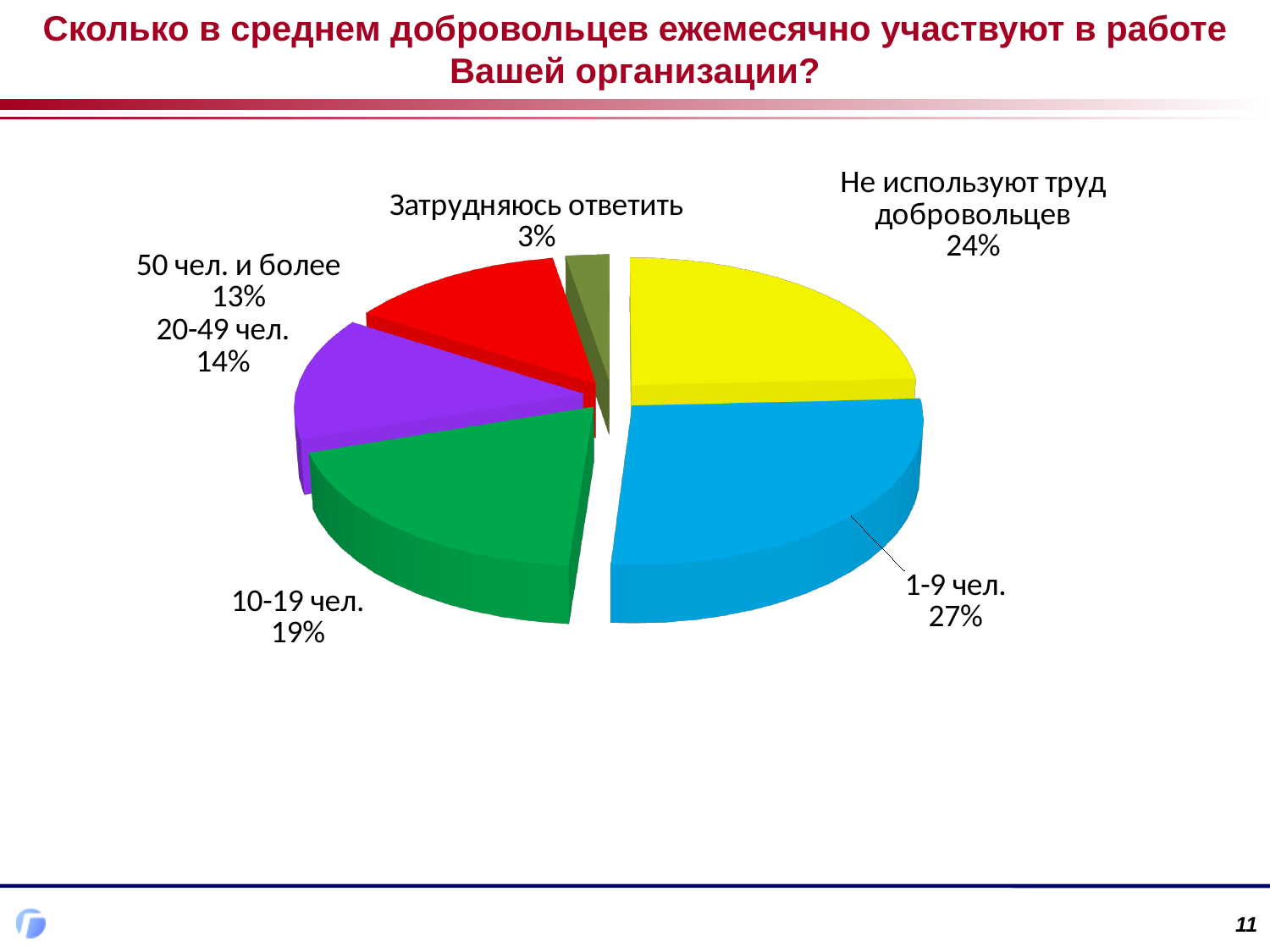
Which is larger: the share for "20-49 чел." or the share for "50 чел. и более"? 20-49 чел. What is the combined share of "20-49 чел." and "50 чел. и более"? 27% Which category has the largest share of the pie? 1-9 чел. Which category has the smallest share of the pie? Затрудняюсь ответить How many slices does the pie chart have? 6 What share is shown for "10-19 чел."? 19% What is the difference in percentage points between "1-9 чел." and "10-19 чел."? 8 What percentage is shown for "Не используют труд добровольцев"? 24% Which category is represented by the yellow slice? Не используют труд добровольцев What percentage is shown for "Затрудняюсь ответить"? 3% What type of chart is shown on the slide? Pie chart What share of respondents answered "1-9 чел."? 27%